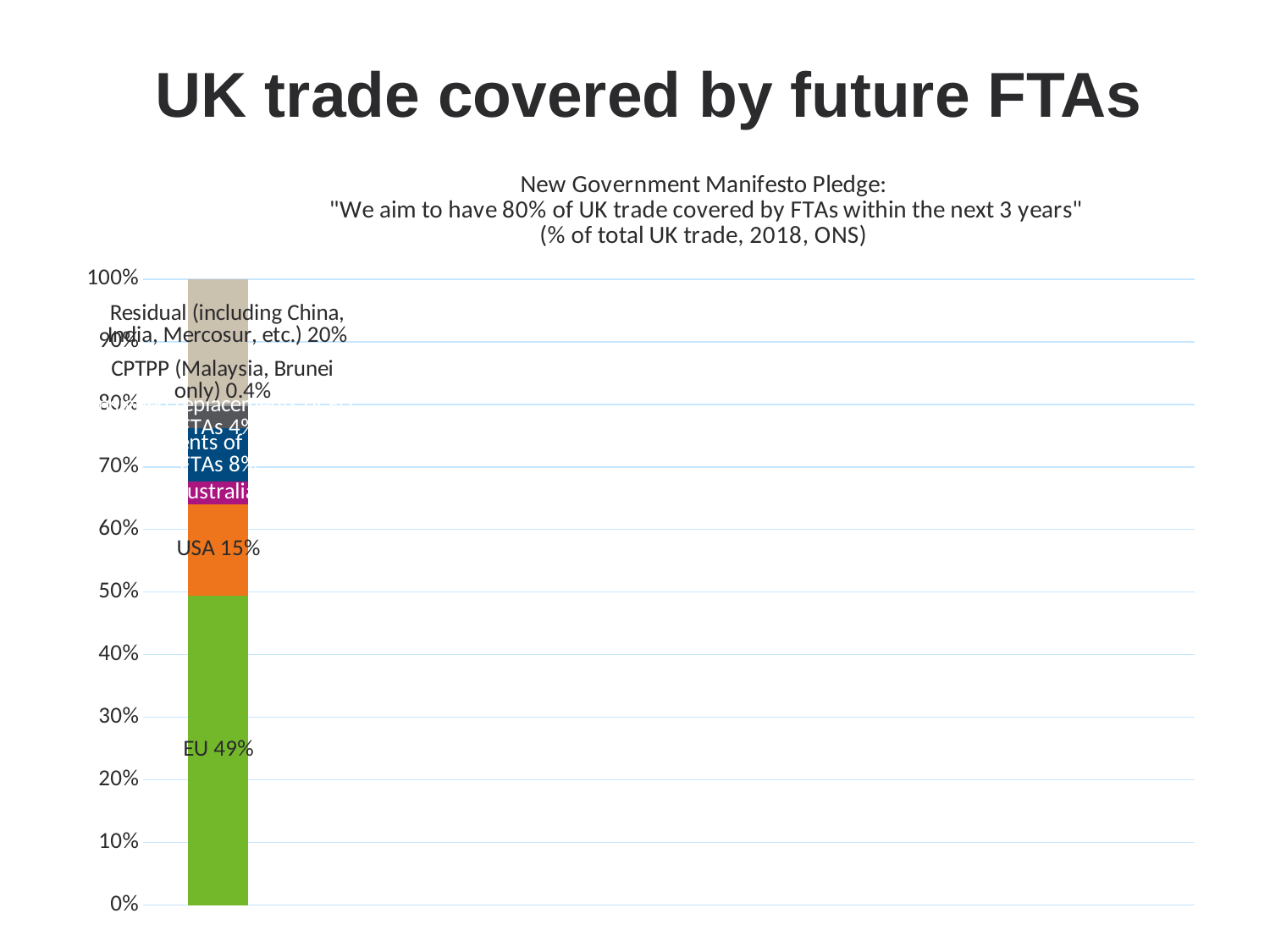
What colour is the EU segment of the bar? Green What percentage is shown for the Residual (including China, India, Mercosur, etc.) segment? 20% What is the difference between the Residual segment and the USA segment? 5% Which is larger, the USA segment or the Residual (including China, India, Mercosur, etc.) segment? Residual (including China, India, Mercosur, etc.) What is the highest value shown on the vertical axis? 100% What kind of chart is shown on the slide? Stacked bar chart What percentage of UK trade is shown for the USA segment? 15% What percentage is shown for the CPTPP (Malaysia, Brunei only) segment? 0.4% What percentage of UK trade is shown for the EU segment? 49% Which labelled segment has the smallest share of UK trade? CPTPP (Malaysia, Brunei only) Which segment of the stacked bar has the largest share of UK trade? EU What is the difference in percentage points between the EU segment and the USA segment? 34%